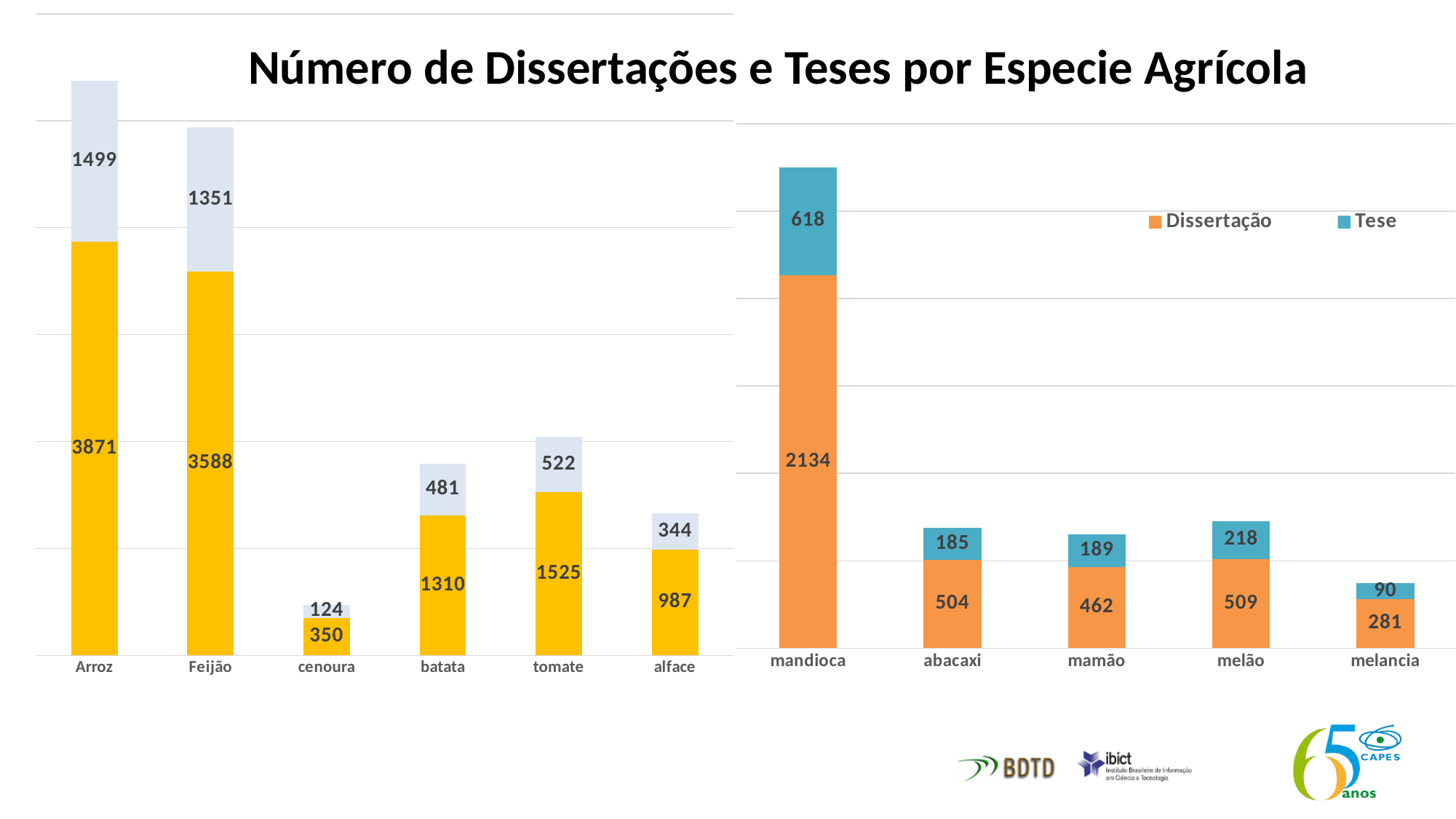
What type of chart is the left chart? Stacked bar chart On the left chart, what is the difference between the yellow segment values for Arroz and Feijão? 283 On the right chart, which is larger, the Dissertação value for mamão or for melão? melão On the right chart, what is the Tese value for melão? 218 How many series does the legend on the right chart list? 2 On the right chart, what is the Dissertação value for mandioca? 2134 On the right chart, what is the total of the stacked bar for abacaxi? 689 On the left chart, what is the value of the yellow (bottom) segment for Arroz? 3871 On the right chart, which category has the highest Dissertação value? mandioca On the left chart, what is the value of the light blue (top) segment for tomate? 522 How many categories are shown on the right chart? 5 On the left chart, which category has the lowest yellow (bottom) segment value? cenoura